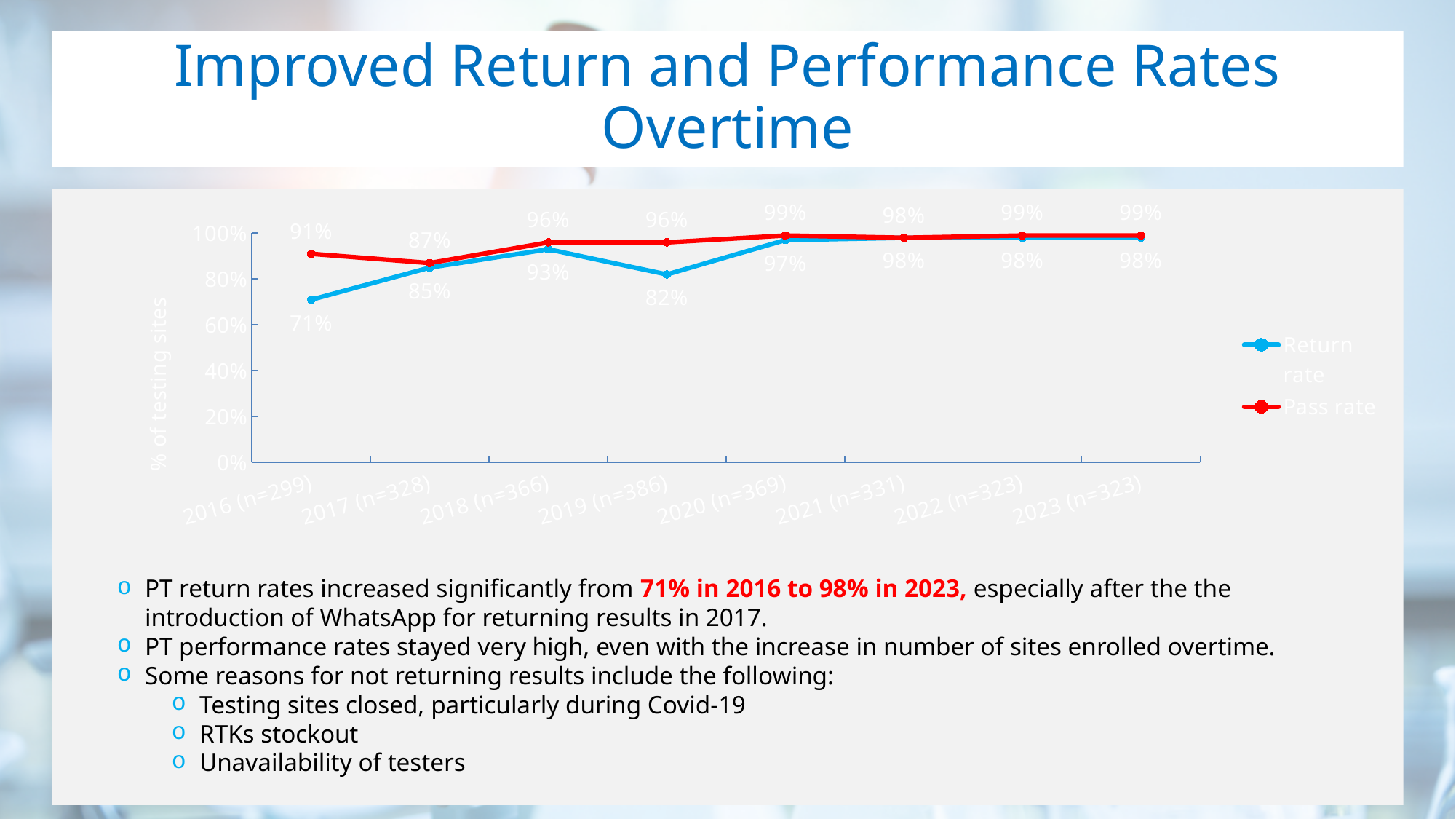
What is the Pass rate for 2019 (n=386)? 96% Is the Return rate for 2019 (n=386) greater or less than 80%? greater What is the Return rate for 2023 (n=323)? 98% How many years are shown on the x axis? 8 What is the difference between the Return rate in 2023 (n=323) and in 2016 (n=299)? 27% What is the Return rate for 2016 (n=299)? 71% How many series does the legend list? 2 Which is larger in 2019 (n=386), the Return rate or the Pass rate? Pass rate In which year is the Pass rate lowest? 2017 (n=328) In which year is the Return rate lowest? 2016 (n=299) What kind of chart is shown on the slide? Line chart What is the difference between the Pass rate and the Return rate in 2016 (n=299)? 20%